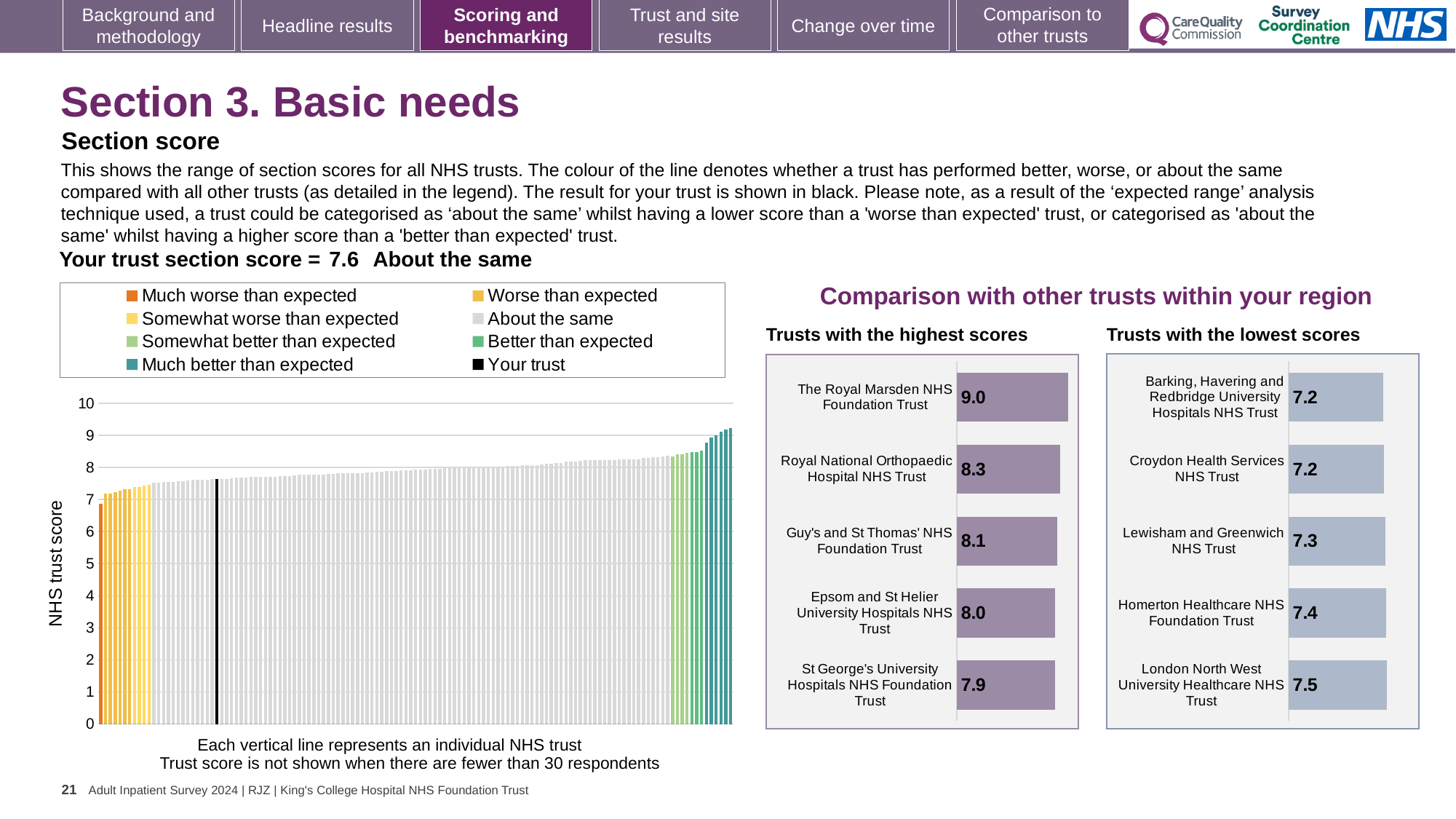
In the 'Trusts with the lowest scores' chart, which has the higher score: Lewisham and Greenwich NHS Trust or London North West University Healthcare NHS Trust? London North West University Healthcare NHS Trust In the 'Trusts with the highest scores' chart, what is the score for The Royal Marsden NHS Foundation Trust? 9.0 In the large chart on the left, do the trust scores rise or fall from left to right? Rise In the 'Trusts with the highest scores' chart, what is the score for Guy's and St Thomas' NHS Foundation Trust? 8.1 What type of chart is the large chart on the left showing the range of section scores for all NHS trusts? Bar chart How many trusts are shown in the 'Trusts with the lowest scores' chart? 5 In the 'Trusts with the highest scores' chart, which trust has the highest score? The Royal Marsden NHS Foundation Trust How many entries does the legend of the large chart on the left list? 8 In the 'Trusts with the lowest scores' chart, what is the score for Homerton Healthcare NHS Foundation Trust? 7.4 In the 'Trusts with the highest scores' chart, what is the difference between the scores of The Royal Marsden NHS Foundation Trust and Royal National Orthopaedic Hospital NHS Trust? 0.7 In the 'Trusts with the lowest scores' chart, what is the score for London North West University Healthcare NHS Trust? 7.5 In the 'Trusts with the highest scores' chart, which trust has the lowest score? St George's University Hospitals NHS Foundation Trust